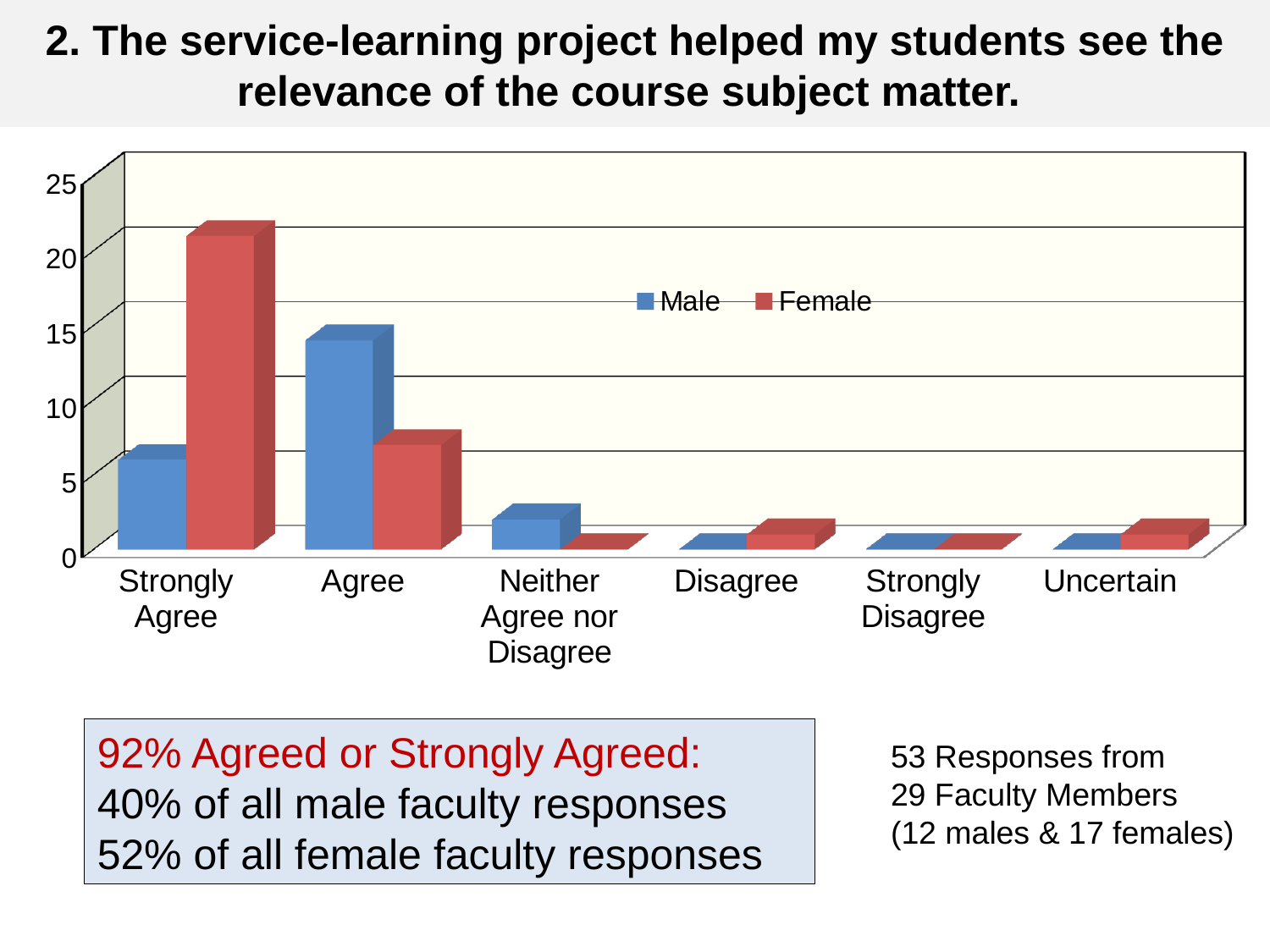
Is the Female value for Strongly Agree greater or less than 15? greater How many response categories are shown on the x axis? 6 Which category has the highest Male value? Agree Which category has the highest Female value? Strongly Agree For Agree, which is larger, the Male or the Female value? Male What kind of chart is shown on the slide? bar chart Is the Female value for Agree greater or less than 10? less What are the two entries in the chart legend? Male and Female Is the Male value for Agree greater or less than 10? greater For Strongly Agree, which is larger, the Male or the Female value? Female How many series does the legend list? 2